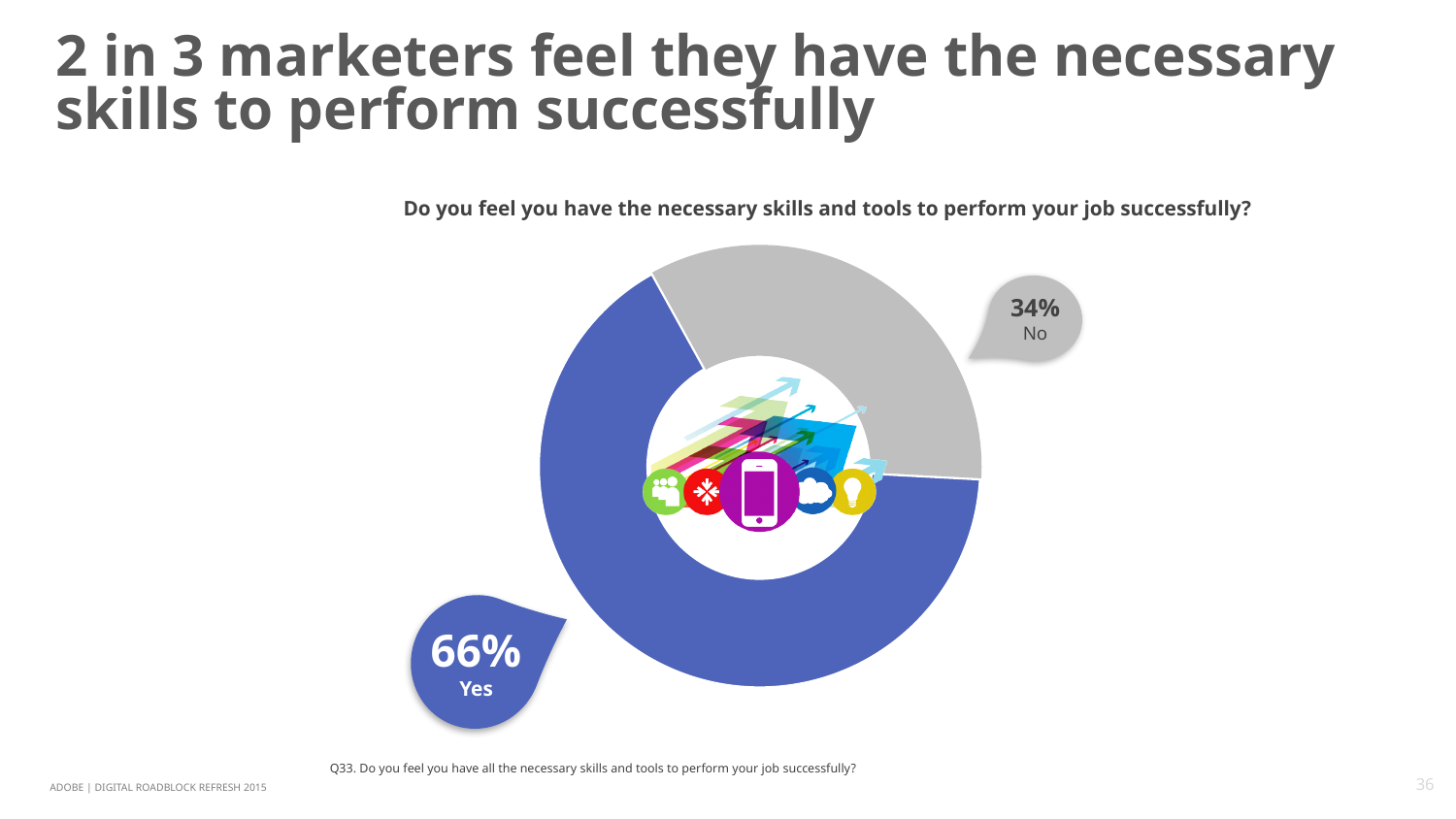
What is the combined total of the Yes and No percentages? 100% Which response has the smallest share of the chart? No What percentage of marketers answered "No"? 34% What colour represents the "Yes" response in the chart? Blue Is the share for "No" greater or less than 50%? less What percentage of marketers answered "Yes" to having the necessary skills and tools? 66% What question is the chart based on, as shown above the chart? Do you feel you have the necessary skills and tools to perform your job successfully? Which response has the larger share of the chart, Yes or No? Yes How many response categories are shown in the chart? 2 What kind of chart is shown on the slide? Doughnut (pie) chart What is the difference in percentage points between the Yes and No responses? 32